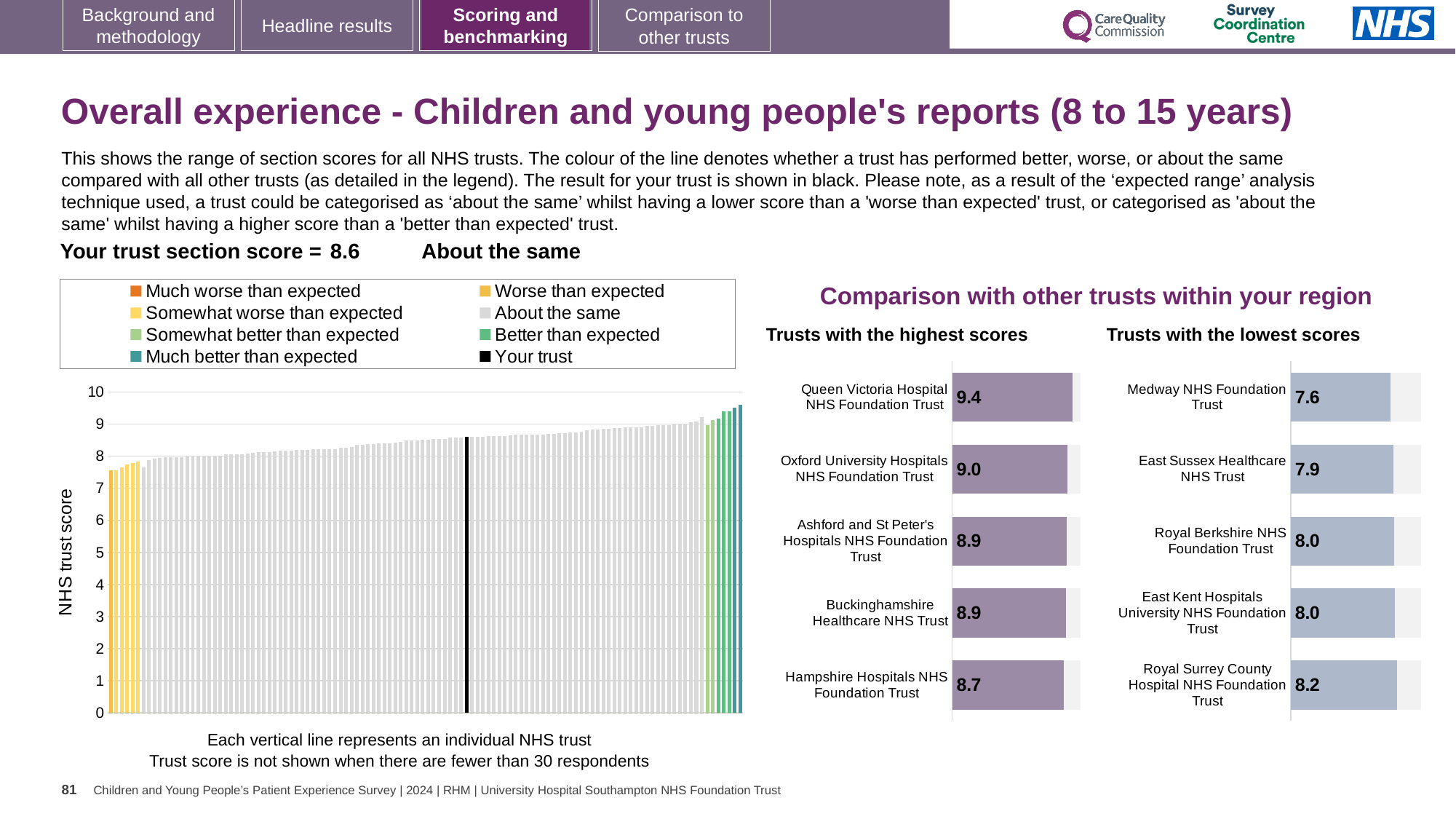
In the NHS trust score chart on the left, is the value of the lowest bar greater or less than 8? less In the 'Trusts with the lowest scores' chart, which has the larger score, East Sussex Healthcare NHS Trust or Royal Berkshire NHS Foundation Trust? Royal Berkshire NHS Foundation Trust How many entries does the legend of the NHS trust score chart on the left list? 8 In the 'Trusts with the highest scores' chart, which trust has the highest score? Queen Victoria Hospital NHS Foundation Trust In the NHS trust score chart on the left, do the bar values rise or fall from left to right? rise In the 'Trusts with the highest scores' chart, what is the score for Hampshire Hospitals NHS Foundation Trust? 8.7 How many trusts are shown in the 'Trusts with the lowest scores' chart? 5 In the 'Trusts with the highest scores' chart, what is the difference between the scores of Queen Victoria Hospital NHS Foundation Trust and Hampshire Hospitals NHS Foundation Trust? 0.7 In the 'Trusts with the highest scores' chart, what is the score for Queen Victoria Hospital NHS Foundation Trust? 9.4 In the 'Trusts with the lowest scores' chart, what is the score for Medway NHS Foundation Trust? 7.6 In the 'Trusts with the lowest scores' chart, what is the score for Royal Surrey County Hospital NHS Foundation Trust? 8.2 In the 'Trusts with the lowest scores' chart, which trust has the lowest score? Medway NHS Foundation Trust